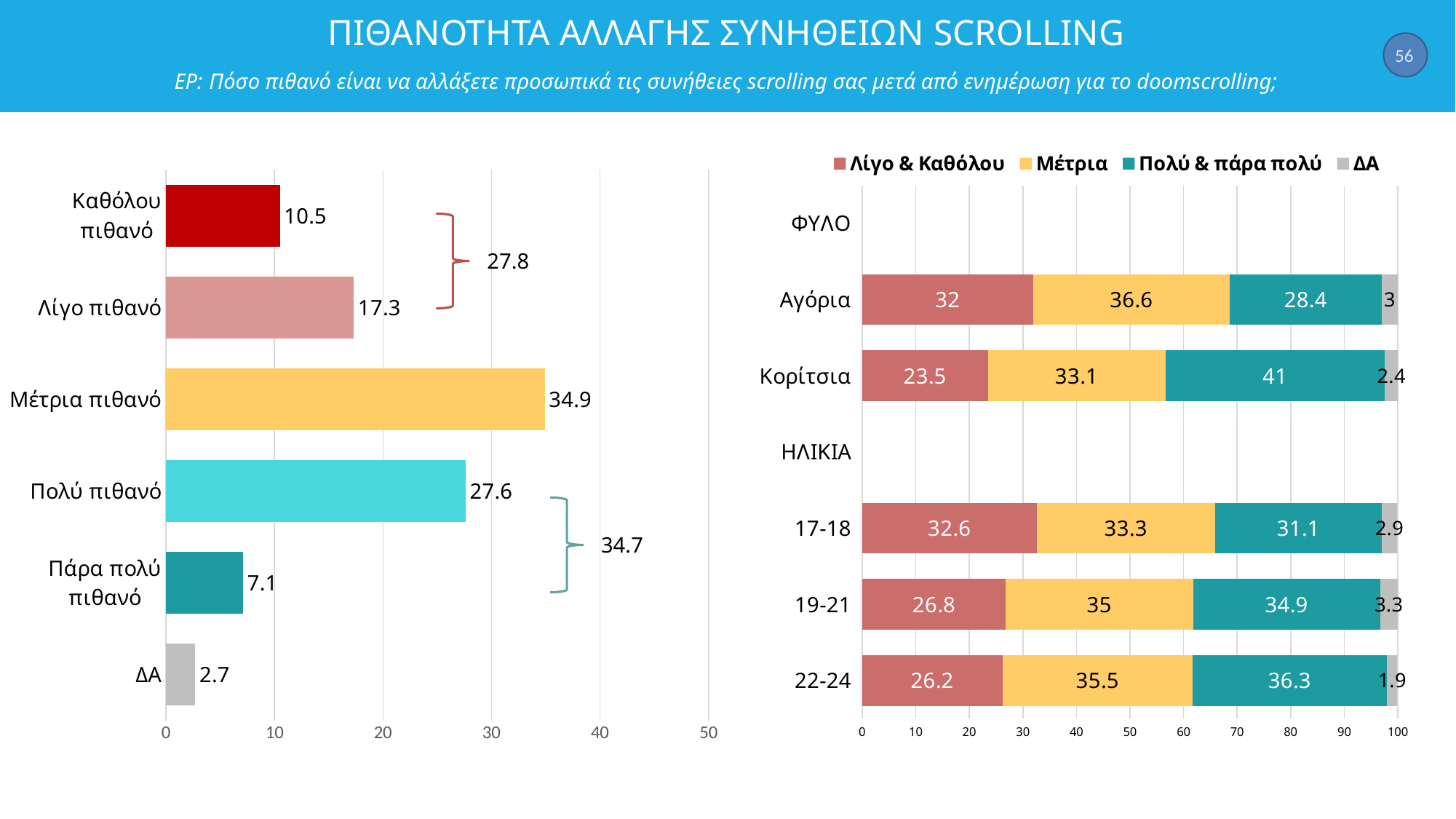
In the right chart, what is the total of the stacked bar for Αγόρια? 100 In the right chart, what is the Πολύ & πάρα πολύ value for Κορίτσια? 41 In the left chart, which category has the highest value? Μέτρια πιθανό In the left chart, which category has the lowest value? ΔΑ What kind of chart is the left chart? bar chart In the right chart, how many series does the legend list? 4 In the left chart, what is the value for Μέτρια πιθανό? 34.9 In the left chart, which is larger: Πολύ πιθανό or Πάρα πολύ πιθανό? Πολύ πιθανό In the right chart, which category has the highest Πολύ & πάρα πολύ value? Κορίτσια In the right chart, what is the Λίγο & Καθόλου value for 17-18? 32.6 In the left chart, how many categories are shown? 6 In the left chart, what is the difference between Λίγο πιθανό and Καθόλου πιθανό? 6.8